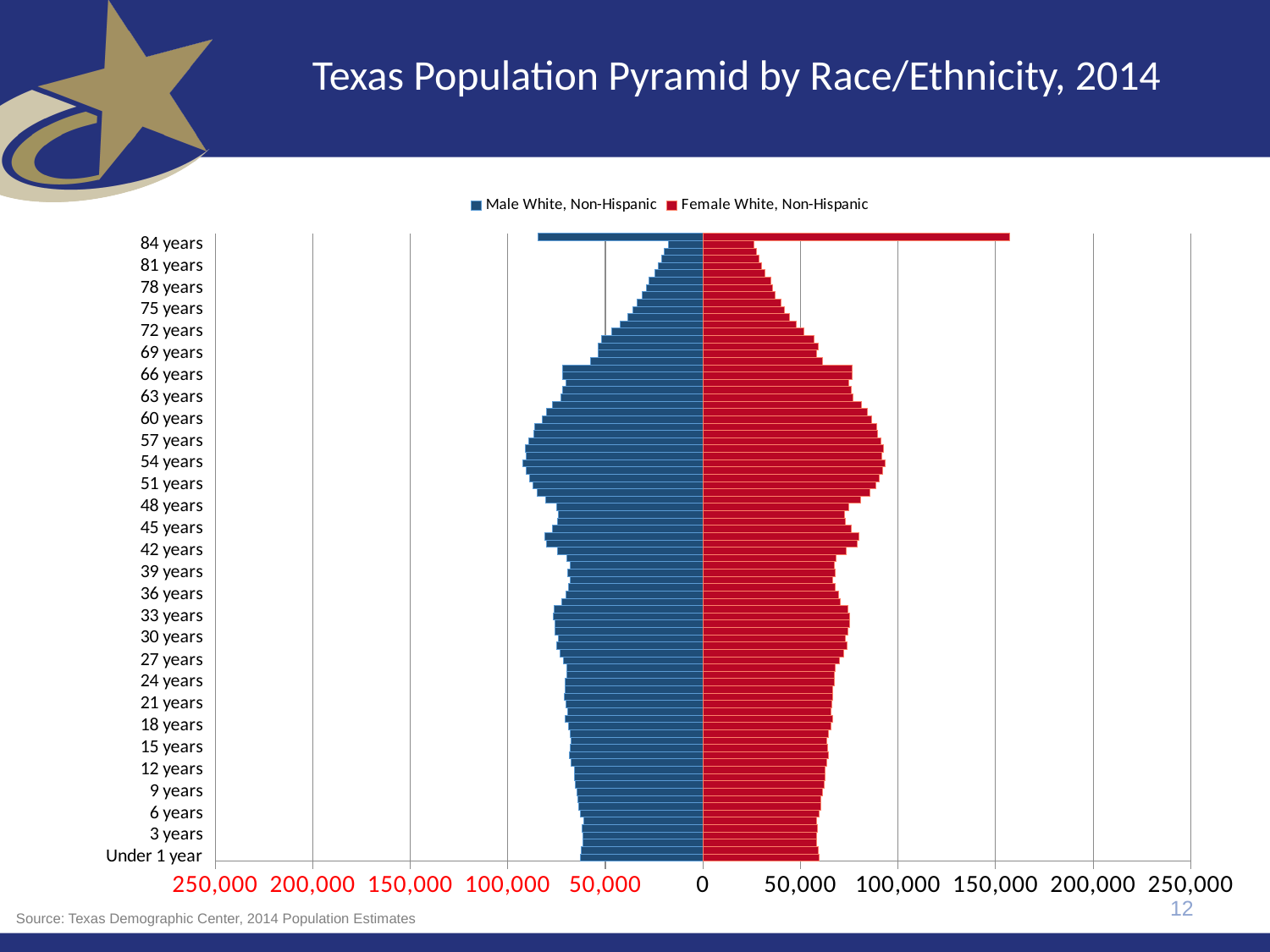
Is the Male White, Non-Hispanic value for 78 years greater or less than 50,000? less Which is larger at 84 years: the Male White, Non-Hispanic bar or the Female White, Non-Hispanic bar? Female White, Non-Hispanic Is the Male White, Non-Hispanic value for 84 years greater or less than 100,000? less Is the Female White, Non-Hispanic value for 54 years greater or less than 50,000? greater What are the two series named in the legend? Male White, Non-Hispanic and Female White, Non-Hispanic How many series does the legend list? 2 What colour represents the Female White, Non-Hispanic series? red What kind of chart is shown on the slide? bar chart